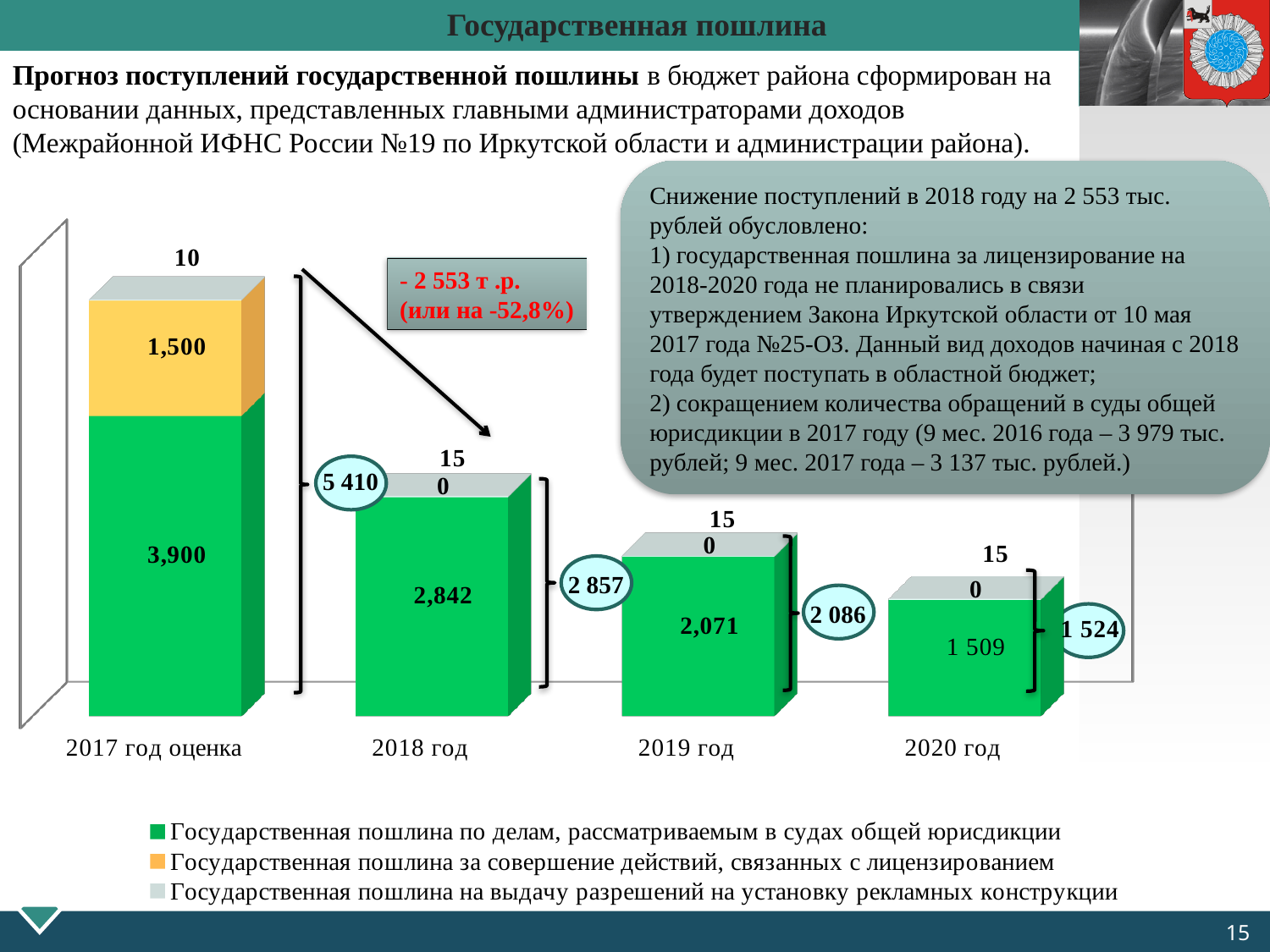
How many years (categories) are shown on the x axis of the chart? 4 How many series does the chart legend list? 3 What is the value for 'Государственная пошлина по делам, рассматриваемым в судах общей юрисдикции' in 2020 год? 1 509 Which year has the highest value for 'Государственная пошлина по делам, рассматриваемым в судах общей юрисдикции'? 2017 год оценка Which is larger: the 2018 год or the 2019 год value for 'Государственная пошлина по делам, рассматриваемым в судах общей юрисдикции'? 2018 год Which year has the lowest value for 'Государственная пошлина по делам, рассматриваемым в судах общей юрисдикции'? 2020 год What is the difference between the 2018 год and 2019 год values for 'Государственная пошлина по делам, рассматриваемым в судах общей юрисдикции'? 771 What kind of chart is shown on the slide? Stacked bar chart What is the value for 'Государственная пошлина по делам, рассматриваемым в судах общей юрисдикции' in 2017 год оценка? 3,900 What is the value for 'Государственная пошлина за совершение действий, связанных с лицензированием' in 2017 год оценка? 1,500 What is the total of the stacked bar for 2018 год? 2 857 What is the value for 'Государственная пошлина на выдачу разрешений на установку рекламных конструкции' in 2018 год? 15